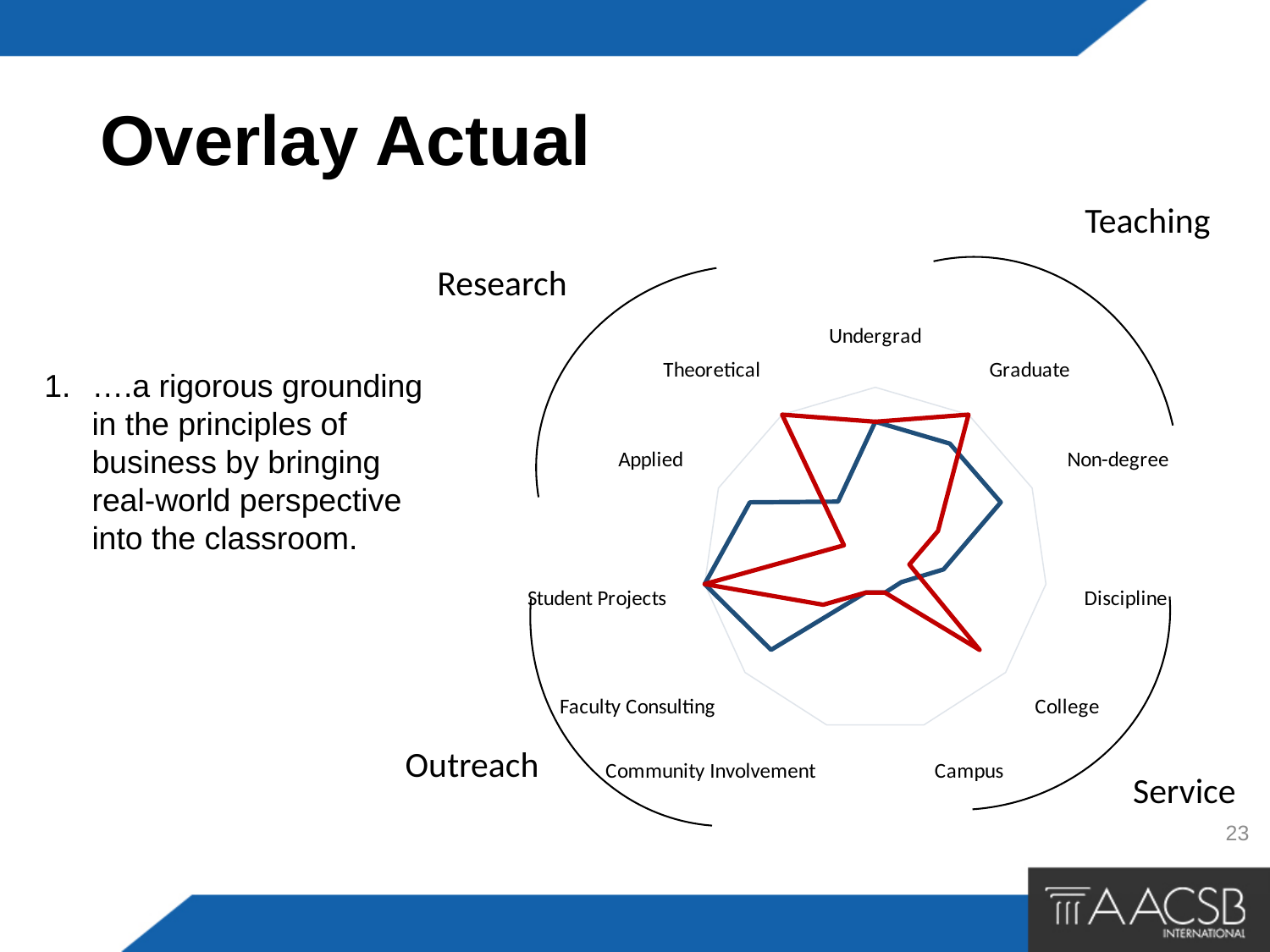
At the Applied axis, which series extends further from the centre, the red or the blue line? Blue What kind of chart is shown on the slide? Radar chart On which axis does the blue series reach its furthest point from the centre? Student Projects How many categories (axes) does the radar chart have? 11 At the Graduate axis, which series extends further from the centre, the red or the blue line? Red How many data series (lines) are plotted on the radar chart? 2 At the Theoretical axis, which series extends further from the centre, the red or the blue line? Red What colours are the two series plotted on the radar chart? Red and blue